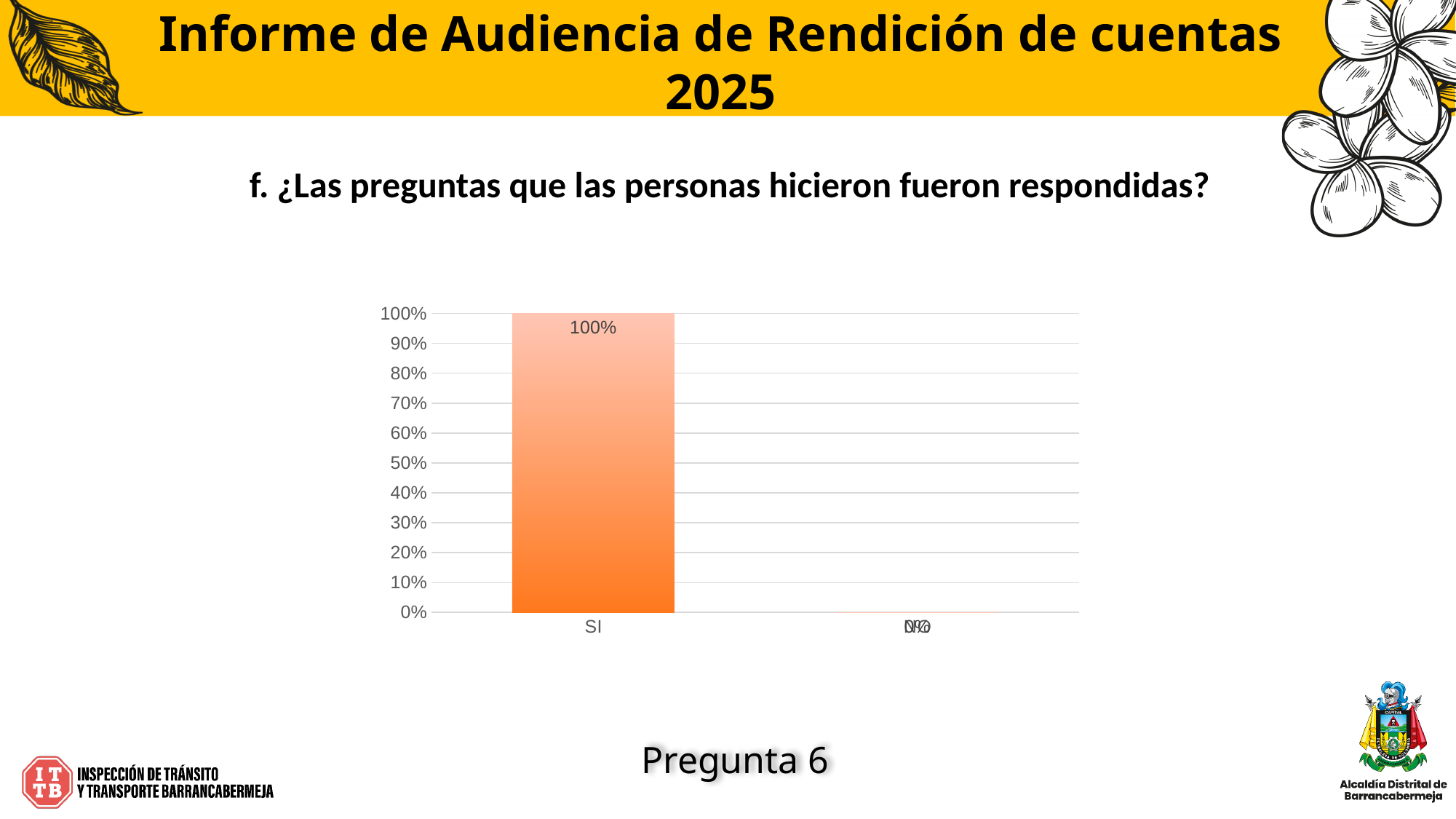
Which category has the highest value? SI What is the value for SI? 100% What question does the chart on the slide report results for? f. ¿Las preguntas que las personas hicieron fueron respondidas? What kind of chart is shown on the slide? bar chart What is the highest value shown on the y axis of the chart? 100% Is the value for SI greater or less than 90%? greater How many categories are shown on the x axis of the chart? 2 Is the value for SI greater or less than 50%? greater